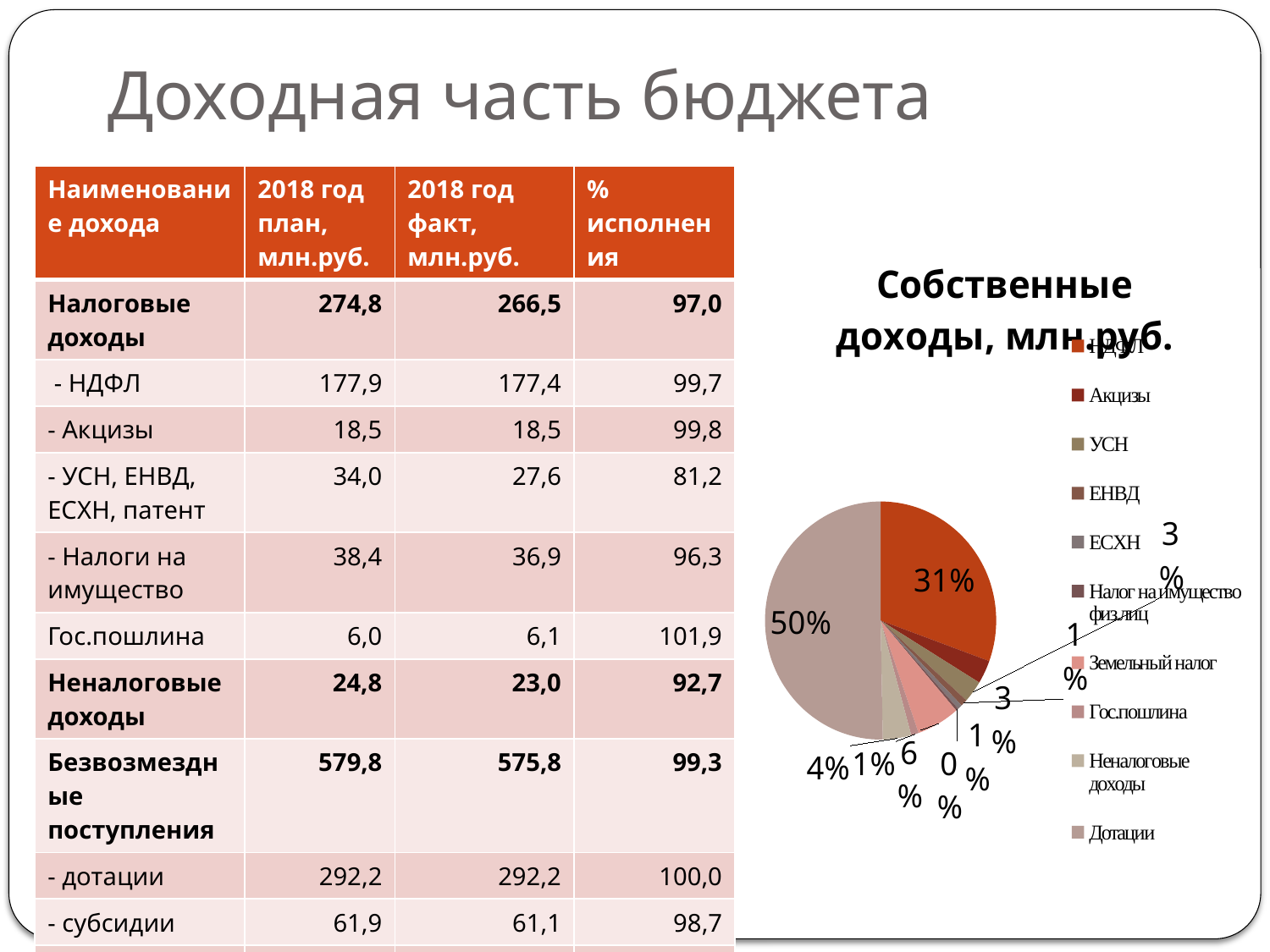
Which legend entry is listed last in the pie chart's legend? Дотации What is the title of the pie chart? Собственные доходы, млн.руб. Which category has the largest slice in the pie chart? Дотации How many entries does the legend of the pie chart list? 10 What share of the pie does Дотации take? 50% What kind of chart is shown on the slide? pie chart What is the difference in percentage points between the Дотации slice and the НДФЛ slice? 19 What is the combined share of the НДФЛ and Дотации slices? 81% What share of the pie does НДФЛ take? 31% What share of the pie does Неналоговые доходы take? 4% Which slice is larger in the pie chart, НДФЛ or Дотации? Дотации Which slice is larger in the pie chart, НДФЛ or Неналоговые доходы? НДФЛ